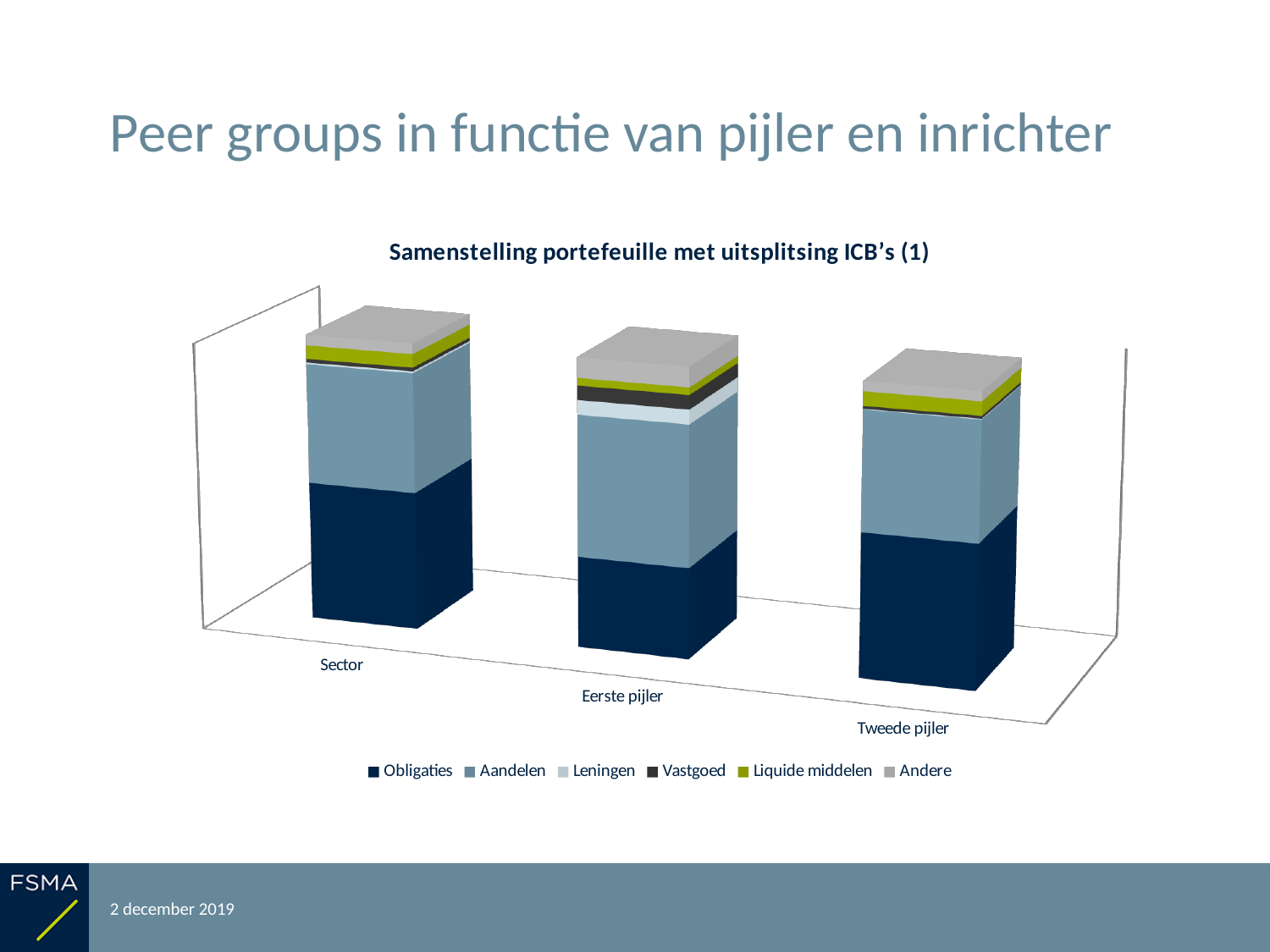
How many categories are shown along the x axis of the chart? 3 Which category shows a clearly visible Leningen segment? Eerste pijler Which series forms the bottom segment of each stacked bar? Obligaties What kind of chart is shown on the slide? Stacked bar chart How many series does the chart's legend list? 6 Which category has the smallest Obligaties segment? Eerste pijler Is the Obligaties segment larger for Sector or for Eerste pijler? Sector What is the title of the chart? Samenstelling portefeuille met uitsplitsing ICB's (1) Which category has the largest Vastgoed segment? Eerste pijler